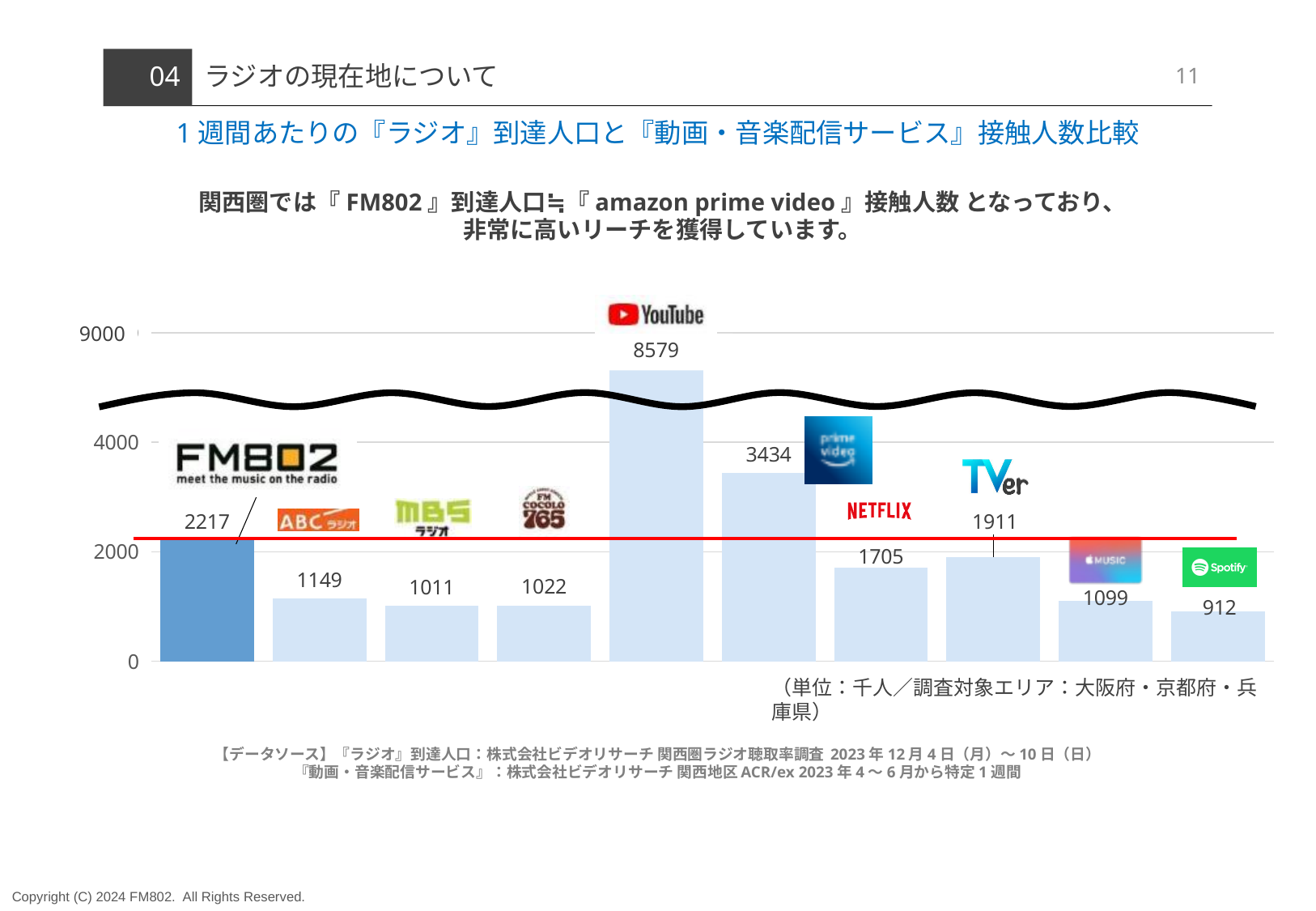
Which category has the highest value? YouTube What is the value for FM802? 2217 How many bars are shown in the chart? 10 Which is larger, the value for ABCラジオ or the value for Apple Music? ABCラジオ Which category has the lowest value? Spotify What unit is stated for the values in the chart? 千人 What is the value for YouTube? 8579 What is the difference between the values for YouTube and prime video? 5145 What kind of chart is shown on the slide? Bar chart What is the difference between the values for FM802 and TVer? 306 What is the value for Spotify? 912 What is the value for Netflix? 1705